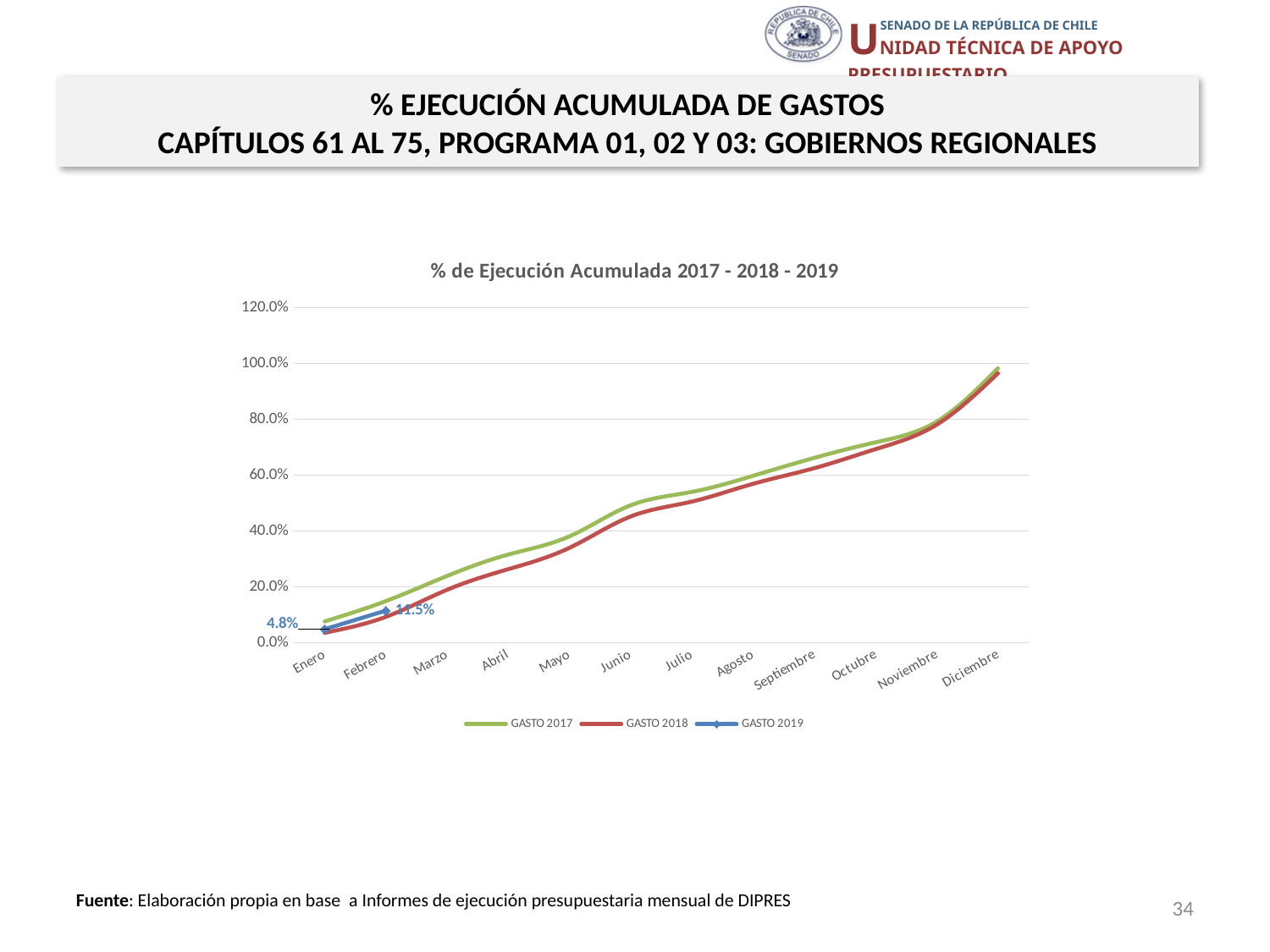
Is the value for GASTO 2017 in Diciembre greater or less than 80%? greater How many series does the legend list? 3 Do the GASTO 2017 and GASTO 2018 values rise or fall from Enero to Diciembre? Rise What is the title of the chart? % de Ejecución Acumulada 2017 - 2018 - 2019 By how much did GASTO 2019 increase from Enero to Febrero? 6.7% Is the value for GASTO 2017 in Marzo greater or less than 40%? less How many months are shown on the x axis? 12 What is the value for GASTO 2019 in Enero? 4.8% What kind of chart is shown on the slide? Line chart In Mayo, which series has the higher value, GASTO 2017 or GASTO 2018? GASTO 2017 What is the value for GASTO 2019 in Febrero? 11.5% Is the value for GASTO 2018 in Junio greater or less than 60%? less